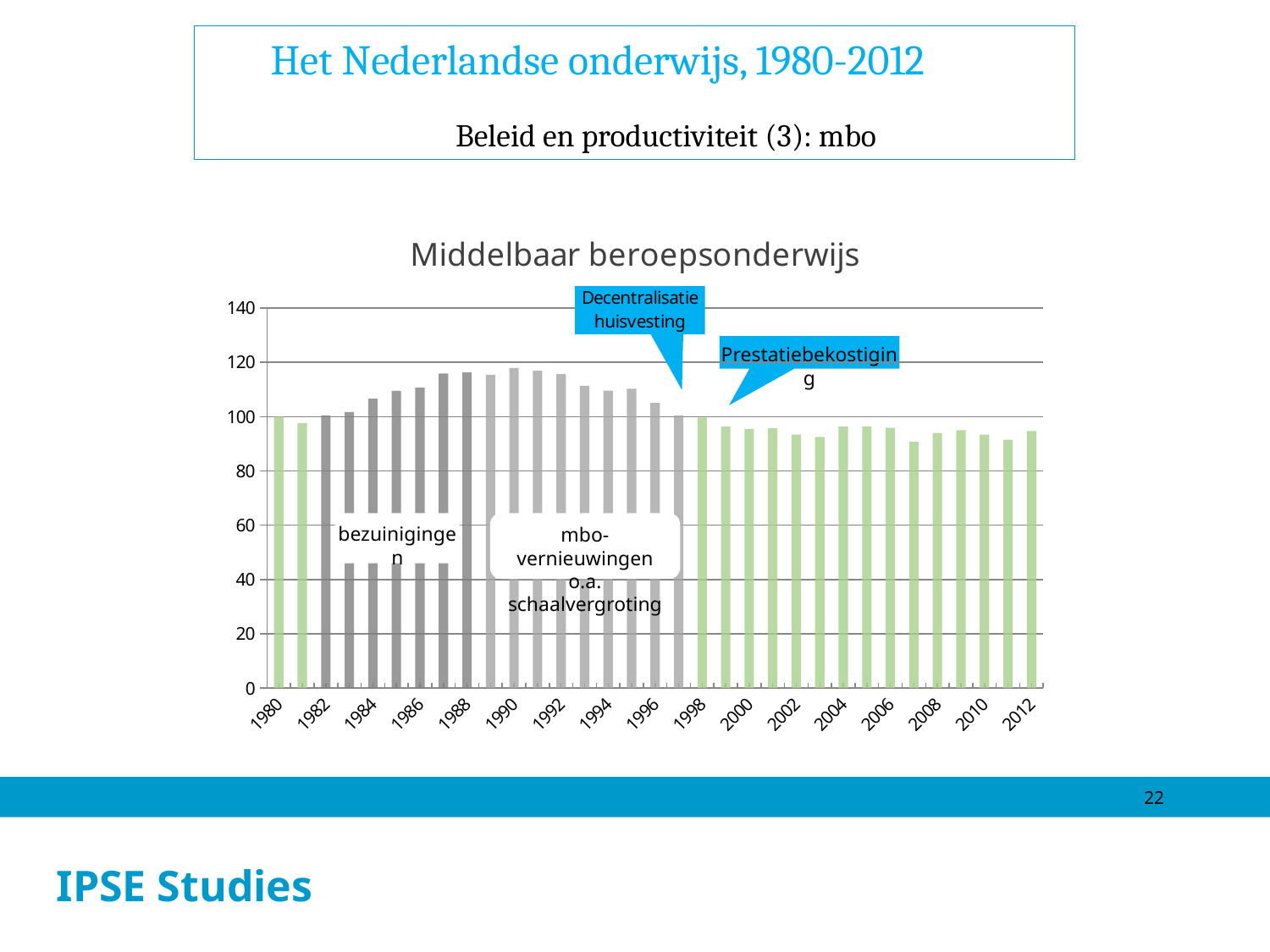
Do the values rise or fall from 1990 to 1997? fall What is the title of the chart? Middelbaar beroepsonderwijs What is the value for 1980? 100 Do the values rise or fall from 1980 to 1990? rise Which is larger, the value for 1990 or the value for 2010? 1990 Is the value for 1990 greater or less than 100? greater Is the value for 2012 greater or less than 100? less Is the value for 2003 greater or less than 80? greater What kind of chart is shown under the title "Middelbaar beroepsonderwijs"? bar chart Which is larger, the value for 1986 or the value for 2000? 1986 How many years (bars) are plotted on the chart? 33